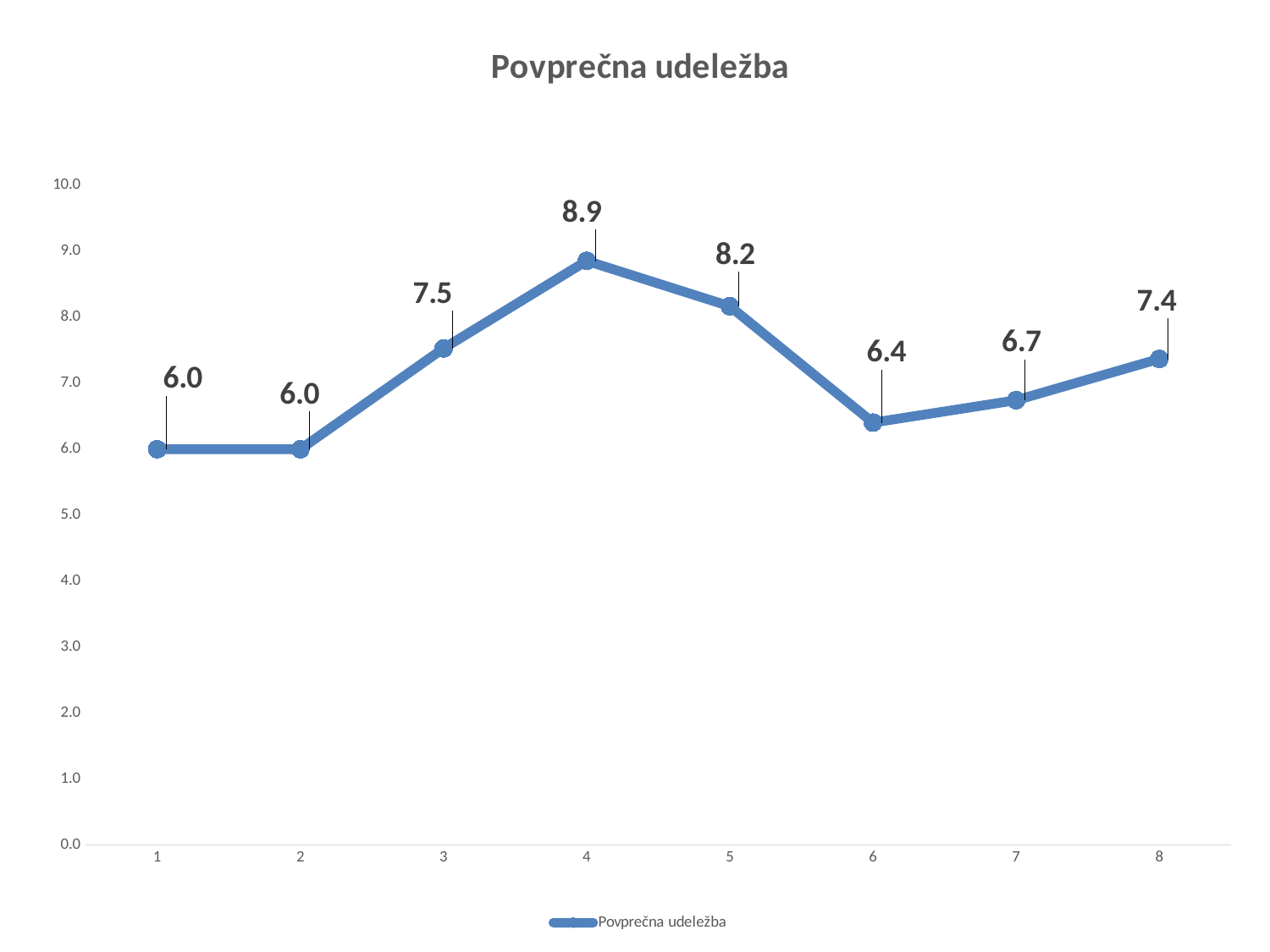
How many data points are plotted on the chart? 8 What is the value for category 6? 6.4 Is the value for category 3 greater or less than 7.0? greater How many series does the legend list? 1 What is the value for category 8? 7.4 What is the title of the chart? Povprečna udeležba Which is larger, the value for category 5 or the value for category 7? category 5 What is the difference between the values for category 4 and category 5? 0.7 What kind of chart is shown? line chart What is the value for category 4? 8.9 What is the difference between the values for category 3 and category 6? 1.1 Which category has the highest value? 4